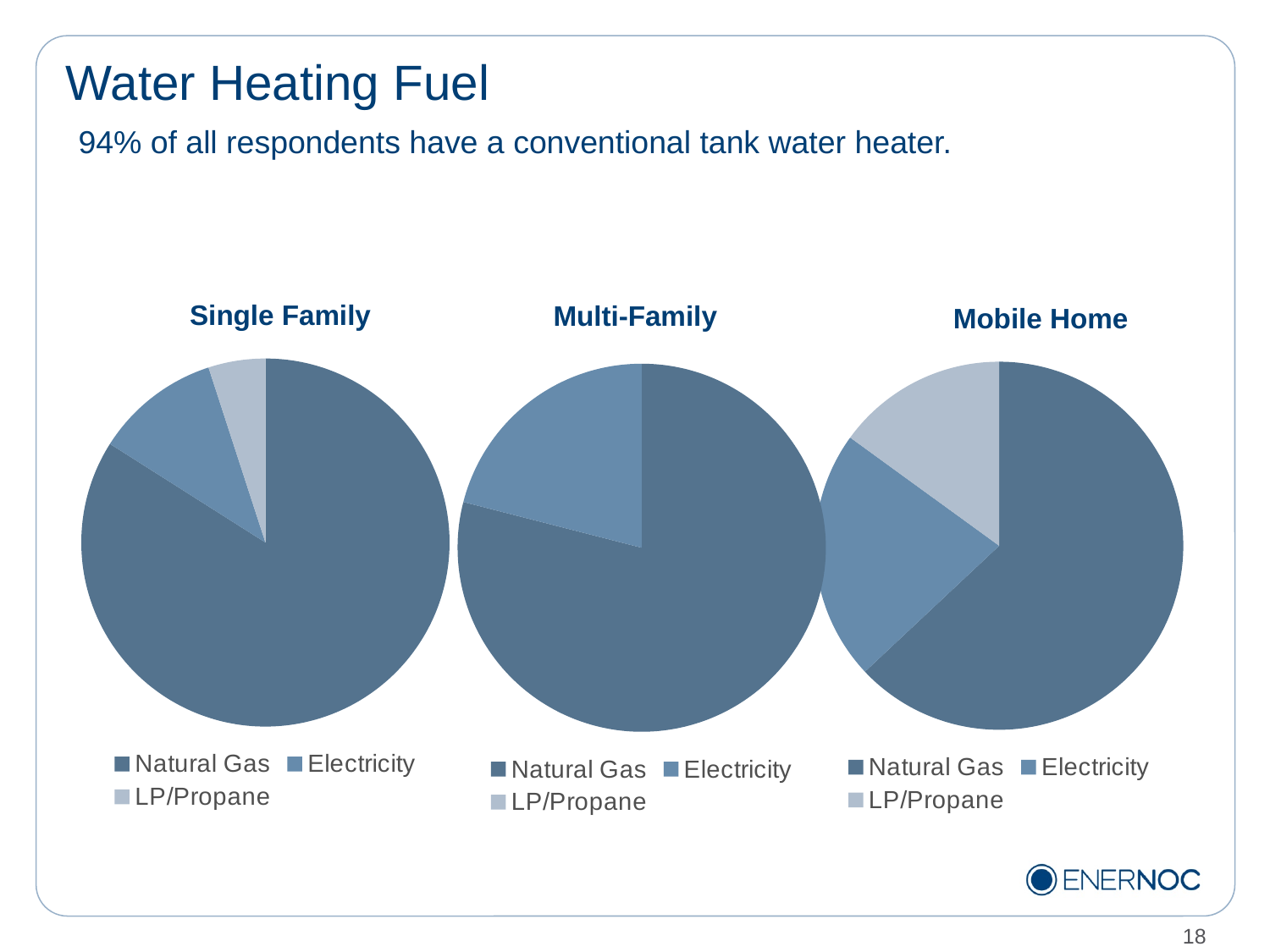
In the Mobile Home chart, which fuel has the largest slice? Natural Gas In the Single Family chart, which slice is larger, Electricity or LP/Propane? Electricity What kind of chart is used for the Single Family chart? Pie chart Which fuel is shown in the lightest colour in the Single Family chart's legend? LP/Propane In the Mobile Home chart, which slice is larger, Natural Gas or LP/Propane? Natural Gas In the Single Family chart, which fuel has the smallest slice? LP/Propane In the Single Family chart, which fuel has the largest slice? Natural Gas In the Multi-Family chart, which fuel has the largest slice? Natural Gas In the Multi-Family chart, which slice is larger, Natural Gas or Electricity? Natural Gas What is the title of the chart on the right of the slide? Mobile Home How many pie charts are shown on the slide? 3 How many categories does the legend of the Mobile Home chart list? 3